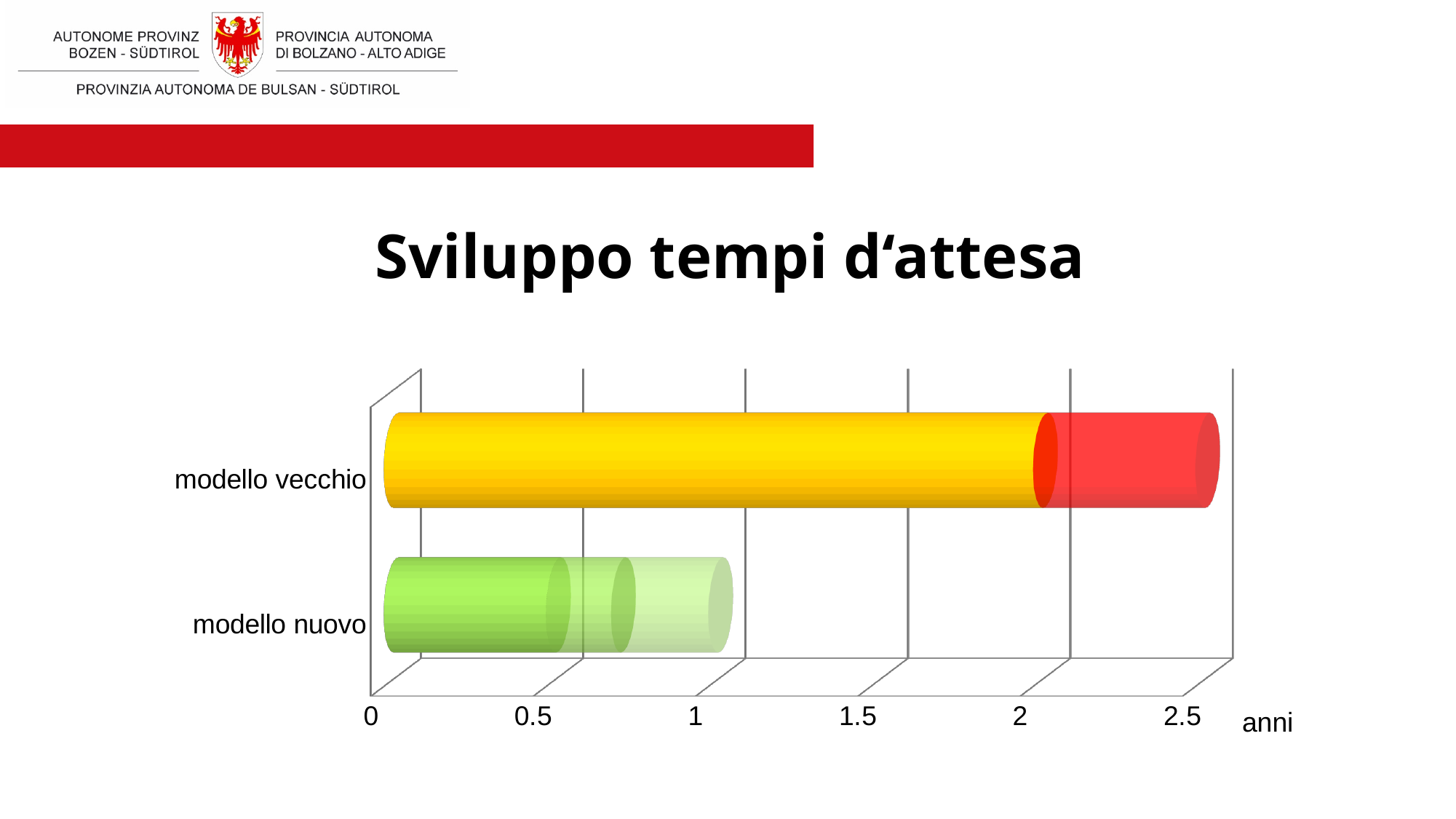
Is the value for modello nuovo greater or less than 1.5? less What unit is shown on the horizontal axis of the chart? anni What kind of chart is shown on the slide? bar chart Which category has the highest value? modello vecchio Which is larger, the value for modello vecchio or the value for modello nuovo? modello vecchio How many categories are shown in the chart? 2 What is the title of the chart? Sviluppo tempi d'attesa Which category has the lowest value? modello nuovo Is the value for modello vecchio greater or less than 2? greater Is the value for modello vecchio greater or less than 1? greater